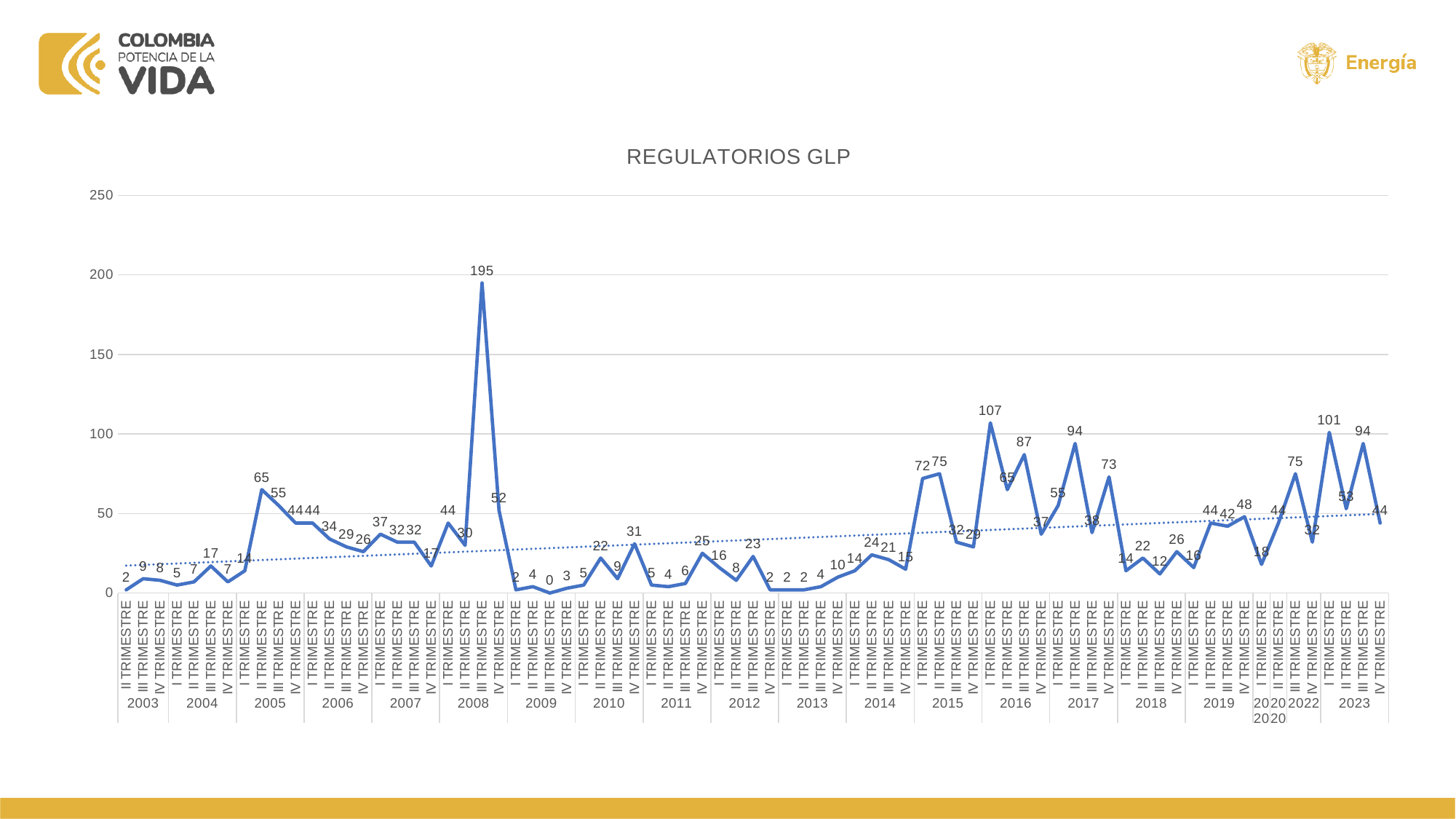
What is the value for III TRIMESTRE 2008? 195 What is the value for II TRIMESTRE 2005? 65 What is the value for I TRIMESTRE 2016? 107 Which quarter has the highest value? III TRIMESTRE 2008 What is the difference between the values for III TRIMESTRE 2008 and IV TRIMESTRE 2008? 143 Which quarter has the lowest value? III TRIMESTRE 2009 What is the title of the chart? REGULATORIOS GLP What is the value for I TRIMESTRE 2023? 101 Which is larger, the value for I TRIMESTRE 2016 or the value for II TRIMESTRE 2017? I TRIMESTRE 2016 Is the value for III TRIMESTRE 2008 greater or less than 150? greater What kind of chart is shown on the slide? line chart Does the dotted trend line rise or fall from left to right? rise